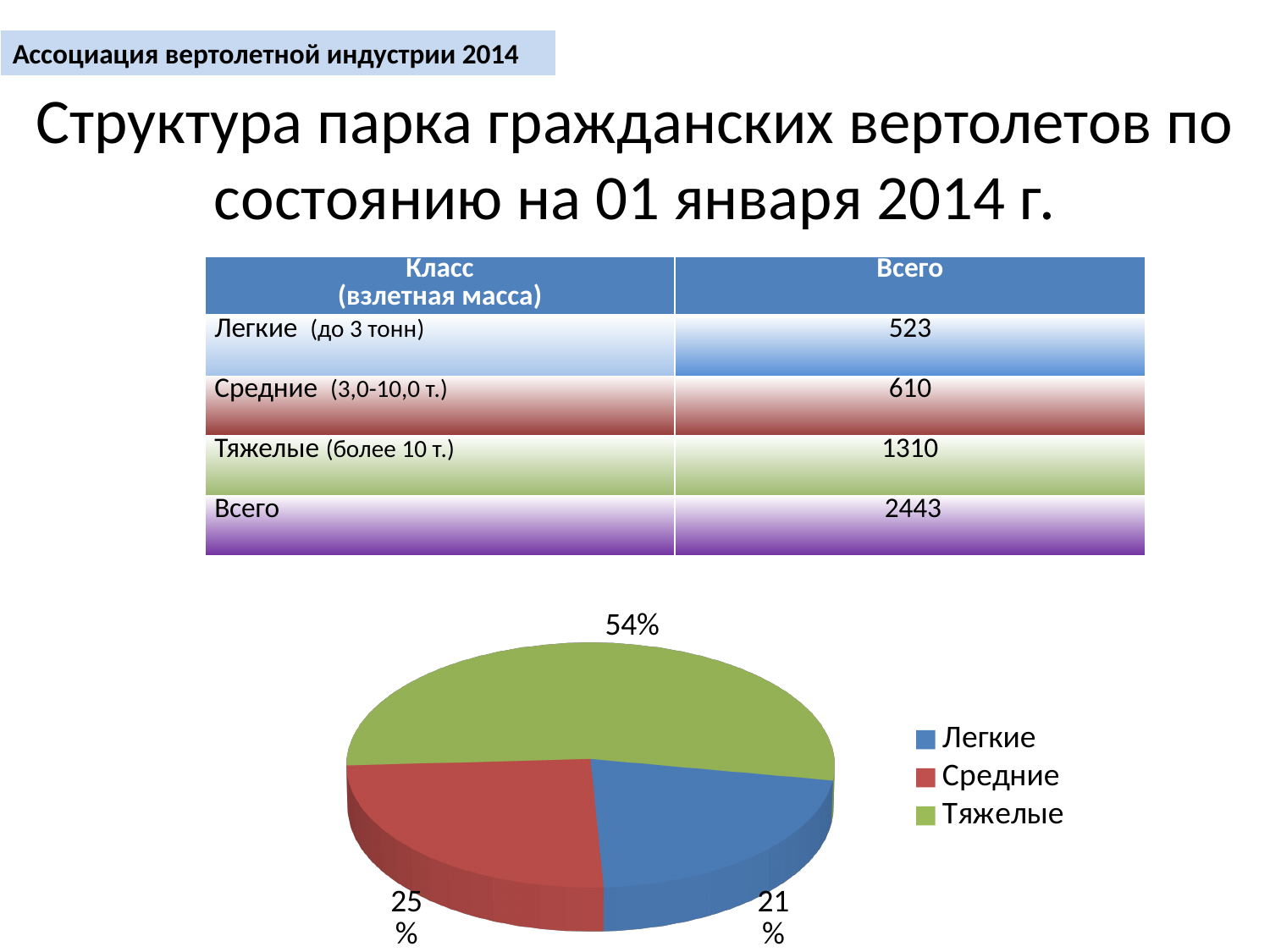
Which category has the largest slice of the pie? Тяжелые What share of the pie does the Средние slice have? 25% What share of the pie does the Легкие slice have? 21% Which legend entry is shown in blue? Легкие What colour is the Тяжелые slice in the pie chart? green How many entries does the legend list? 3 What is the difference in percentage points between the Тяжелые and Средние slices? 29 Which category has the smallest slice of the pie? Легкие What kind of chart is shown on the slide? pie chart How many slices does the pie chart have? 3 Which slice is larger, Средние or Легкие? Средние What share of the pie does the Тяжелые slice have? 54%